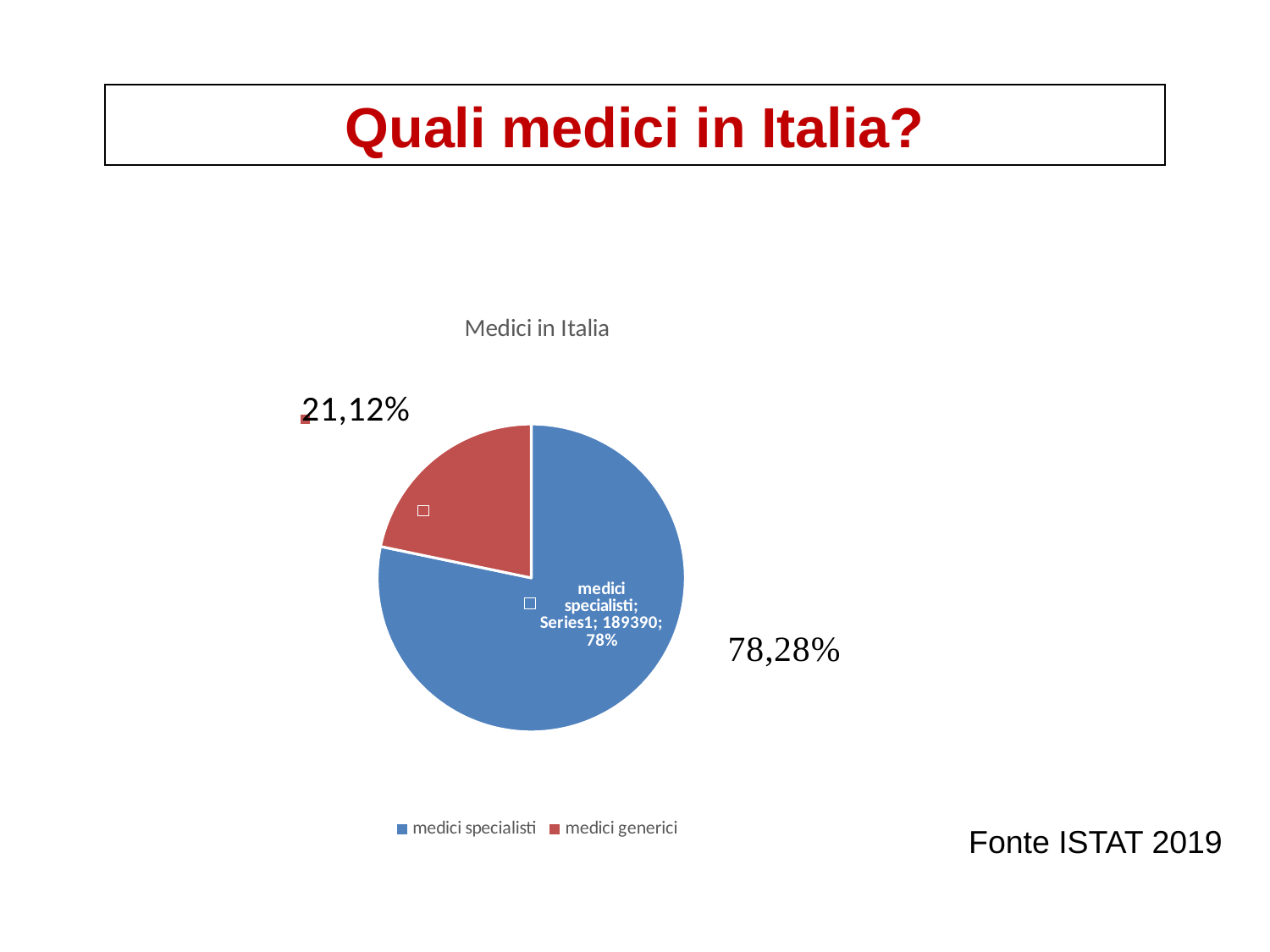
How many entries does the legend list? 2 What percentage is shown next to the medici specialisti slice? 78,28% What percentage is shown next to the medici generici slice? 21,12% What kind of chart is shown on the slide? pie chart Which category has the smallest slice of the pie? medici generici What is the difference in percentage points between the medici specialisti share (78,28%) and the medici generici share (21,12%)? 57,16% Which slice is larger, medici specialisti or medici generici? medici specialisti How many slices does the pie chart have? 2 What colour is the medici generici slice? red What is the title of the chart? Medici in Italia Which category has the largest slice of the pie? medici specialisti What value is printed in the data label for medici specialisti? 189390